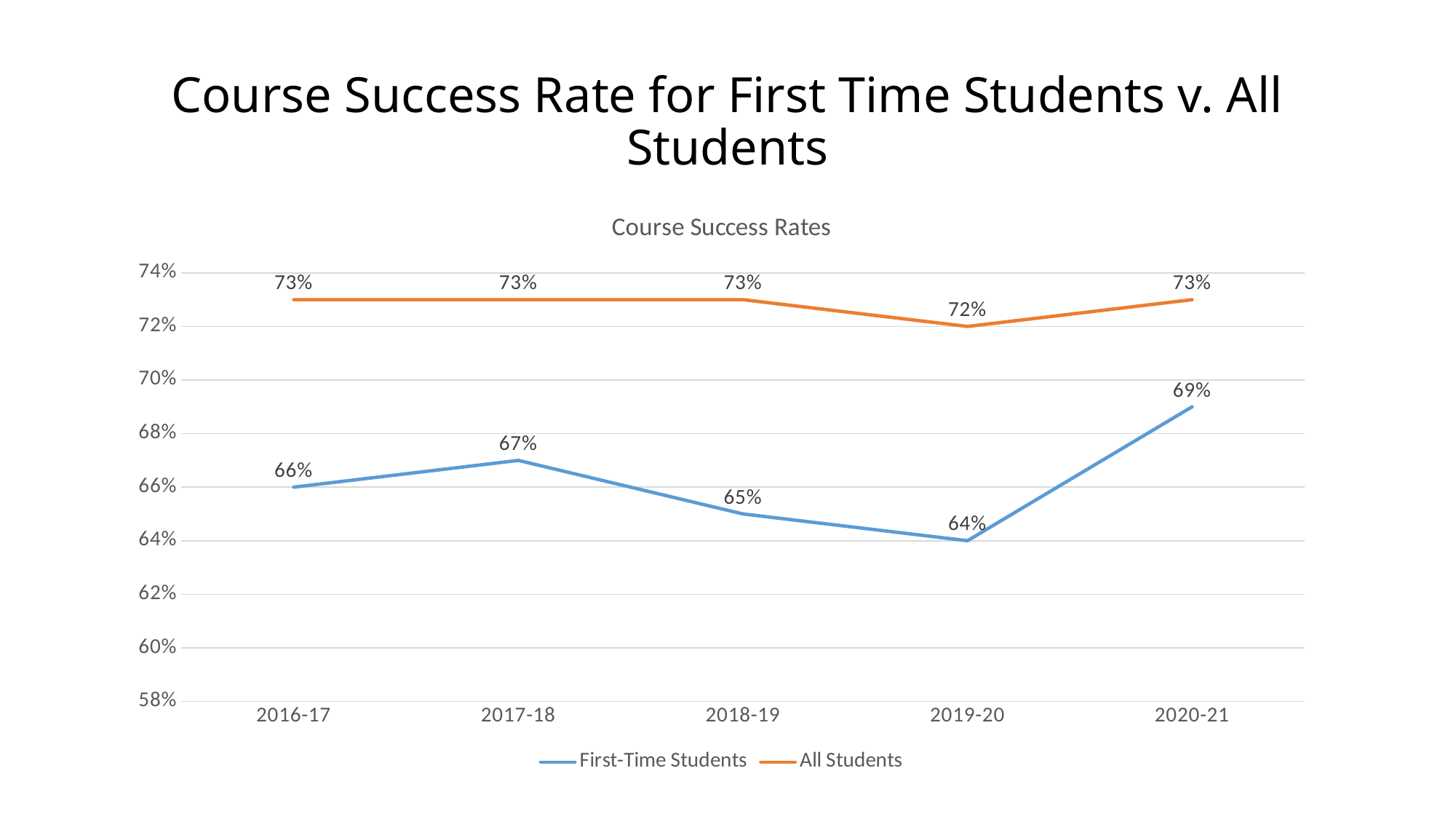
How many academic years are shown on the x axis? 5 What is the difference between the All Students and First-Time Students success rates in 2019-20? 8% What is the course success rate for First-Time Students in 2018-19? 65% In which year is the First-Time Students success rate lowest? 2019-20 What is the course success rate for First-Time Students in 2020-21? 69% What is the course success rate for All Students in 2019-20? 72% How many series does the legend list? 2 What kind of chart is shown on the slide? Line chart What is the title shown above the chart plot area? Course Success Rates In which year is the First-Time Students success rate highest? 2020-21 Which series has the higher success rate in 2016-17, First-Time Students or All Students? All Students What is the difference between the First-Time Students success rate in 2020-21 and in 2019-20? 5%